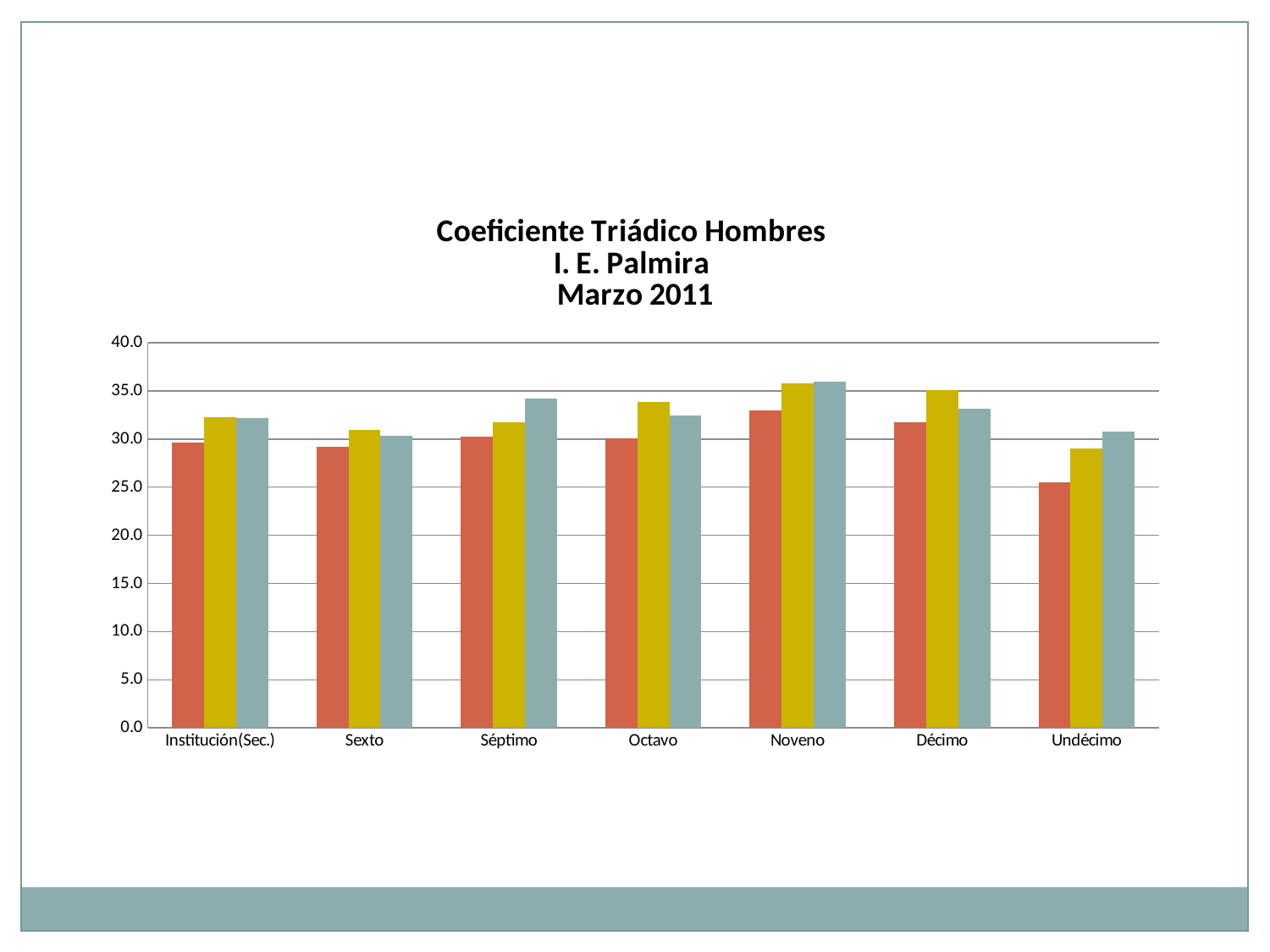
Which category has the highest red bar? Noveno What kind of chart is shown on the slide? Bar chart How many bars are plotted for each category in the chart? 3 Is the value of the teal bar for Noveno greater or less than 35.0? greater What is the title of the chart? Coeficiente Triádico Hombres I. E. Palmira Marzo 2011 How many categories are shown along the x axis of the chart? 7 Which category has the lowest yellow bar? Undécimo Is the value of the red bar for Noveno greater or less than 30.0? greater Which category has the lowest red bar? Undécimo Which category has the highest teal bar? Noveno Is the value of the red bar for Undécimo greater or less than 30.0? less For Séptimo, which is larger: the yellow bar or the teal bar? The teal bar